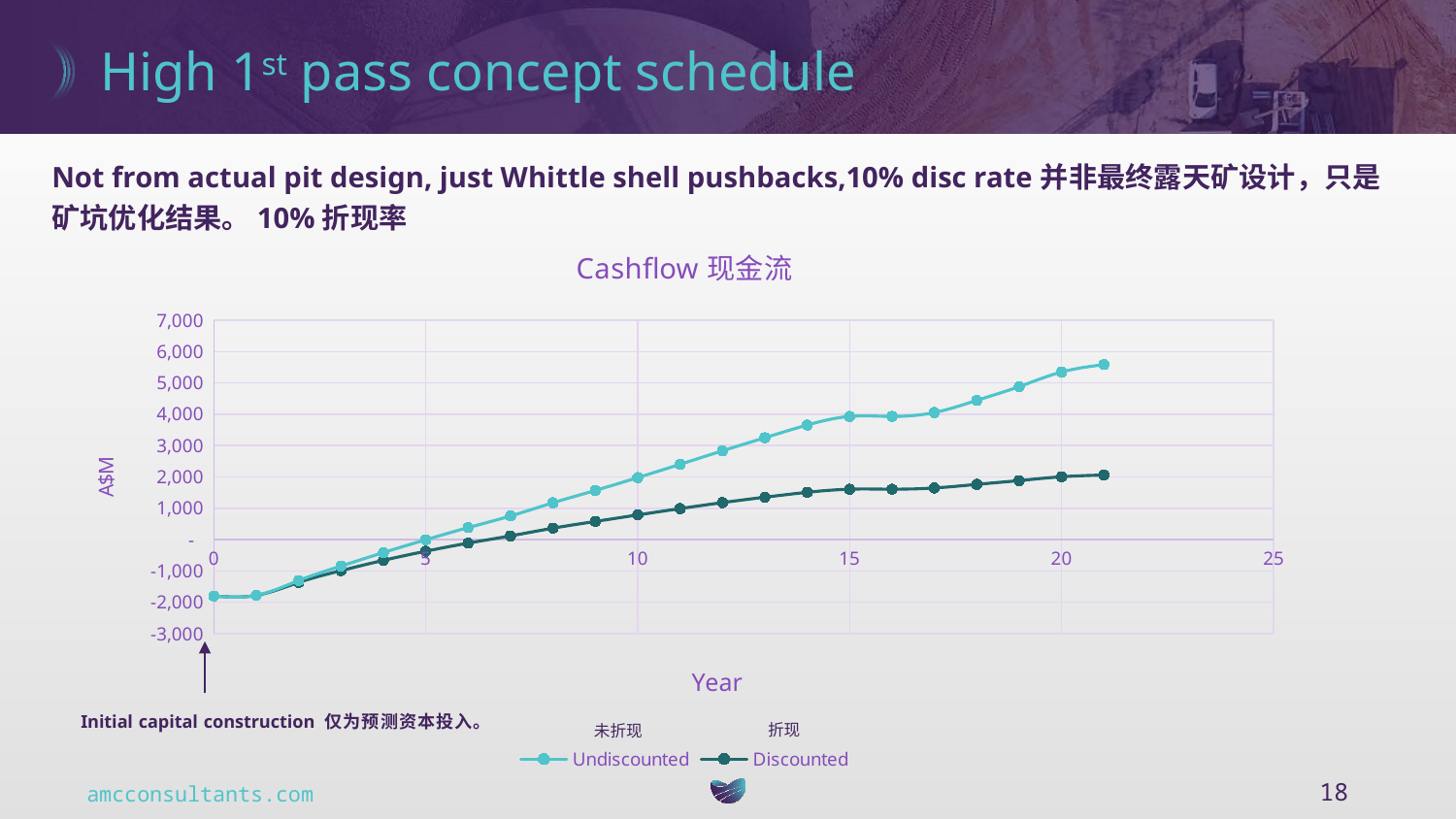
How many series does the legend list? 2 Is the Discounted value at year 20 greater or less than 3,000? less Is the Undiscounted value at year 0 greater or less than -1,000? less Is the Undiscounted value at year 15 greater or less than 3,000? greater What is the label on the vertical axis of the chart? A$M At year 20, which series has the larger value, Undiscounted or Discounted? Undiscounted What kind of chart is shown on the slide? line chart Does the Undiscounted cashflow rise or fall as the year increases? rise What is the title of the chart? Cashflow 现金流 Does the Discounted cashflow rise or fall as the year increases? rise